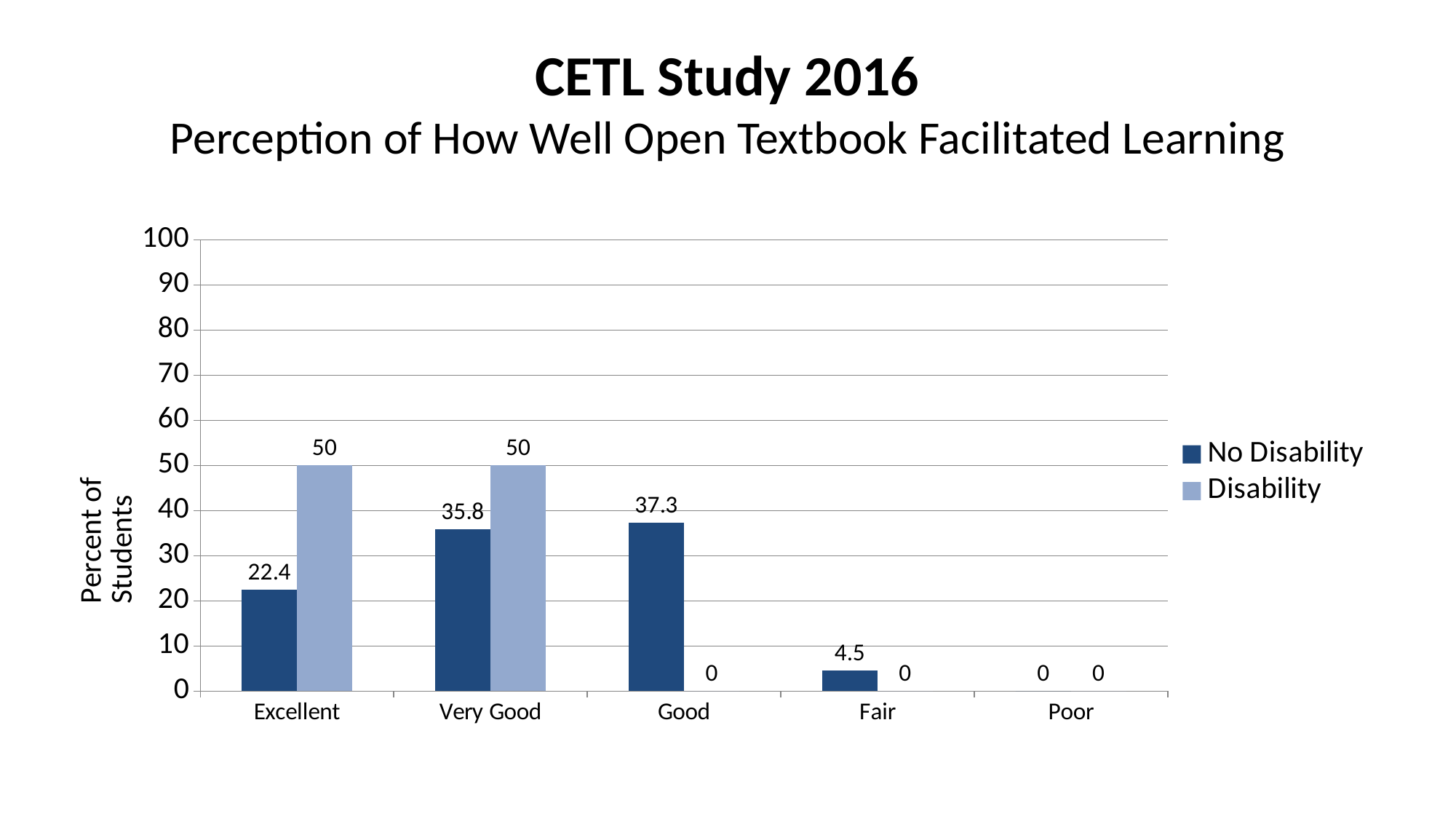
What is the value for Disability in the Good category? 0 How many categories are shown on the x axis? 5 Which category has the lowest value for the No Disability series? Poor What is the value for Disability in the Very Good category? 50 What is the value for No Disability in the Excellent category? 22.4 What is the value for No Disability in the Fair category? 4.5 Which category has the highest value for the No Disability series? Good Which is larger in the Very Good category, No Disability or Disability? Disability How many series does the legend list? 2 What kind of chart is shown on the slide? Bar chart What is the difference between the Disability and No Disability values in the Excellent category? 27.6 What is the label of the y axis? Percent of Students